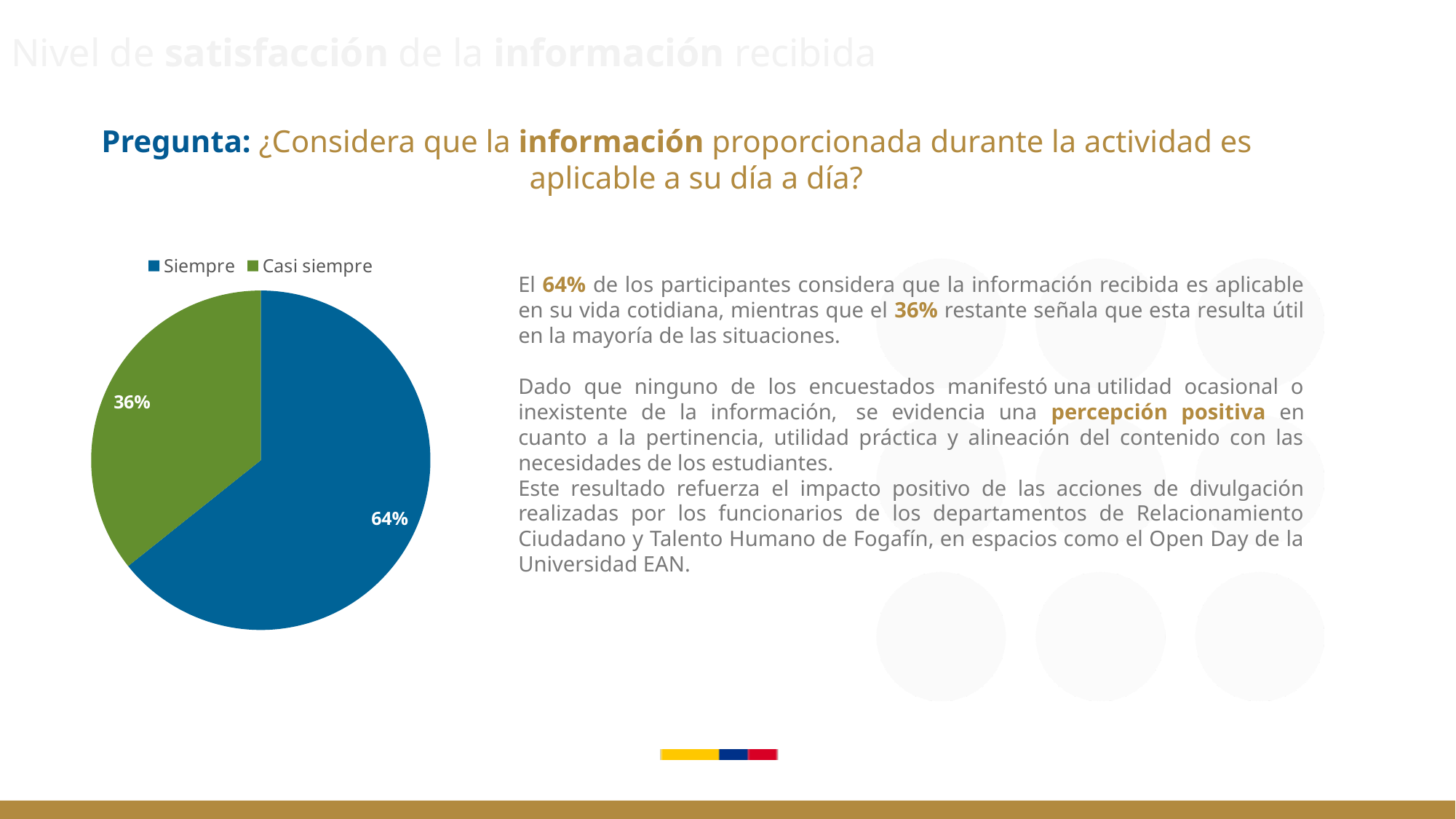
What colour is the "Casi siempre" slice in the pie chart? green What is the combined share of the "Siempre" and "Casi siempre" slices? 100% How many slices does the pie chart have? 2 What percentage of the pie chart corresponds to "Casi siempre"? 36% Which category has the largest share of the pie chart? Siempre Which category has the smallest share of the pie chart? Casi siempre What colour is the "Siempre" slice in the pie chart? blue What kind of chart is shown on the slide? pie chart How many entries does the chart legend list? 2 What percentage of the pie chart corresponds to "Siempre"? 64% Which slice is larger, "Siempre" or "Casi siempre"? Siempre What is the difference in percentage points between the "Siempre" and "Casi siempre" slices? 28